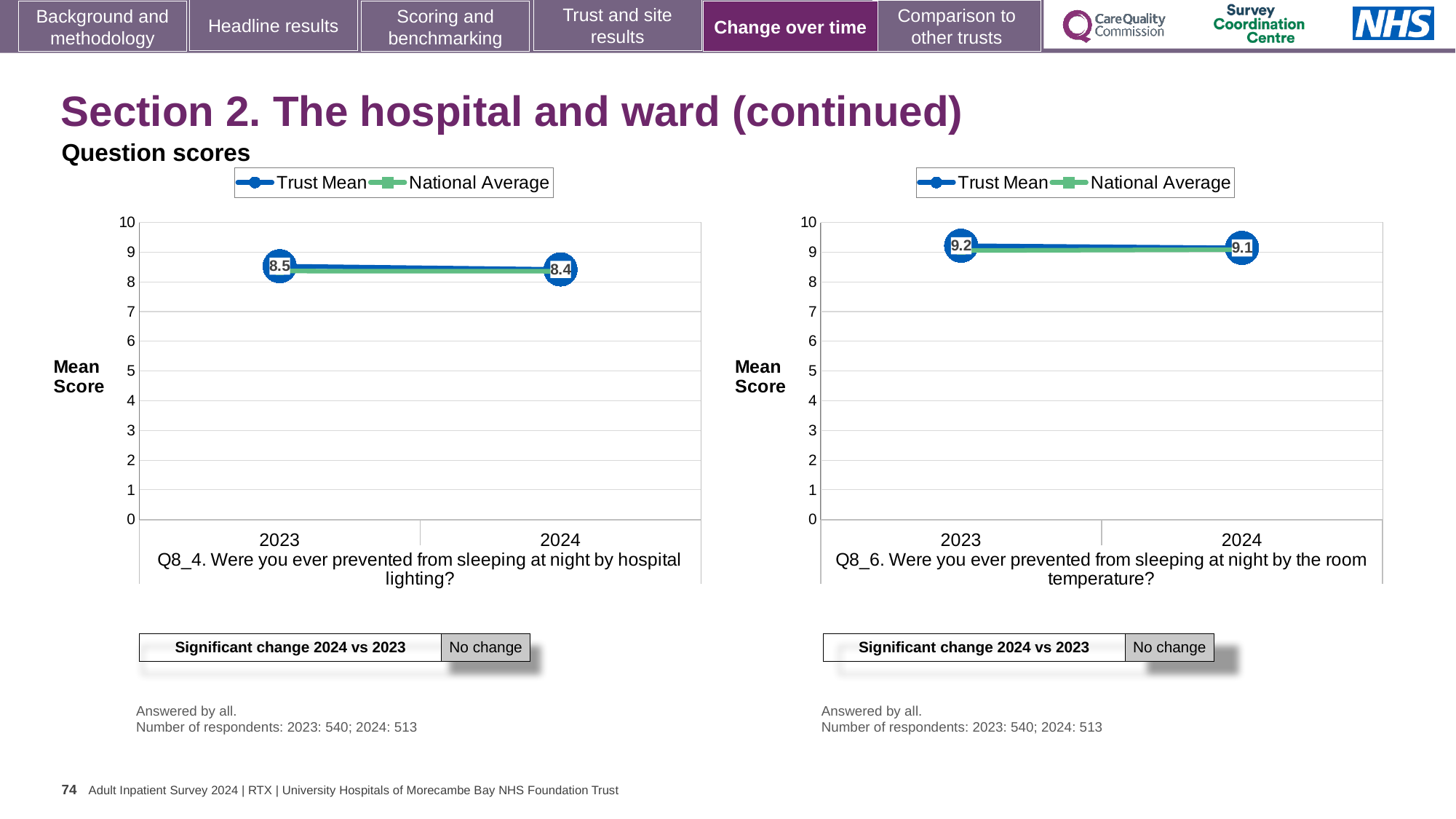
In the right chart (Q8_6, room temperature), what is the Trust Mean for 2024? 9.1 In the right chart (Q8_6, room temperature), is the National Average for 2024 greater or less than 5? greater In the left chart (Q8_4, hospital lighting), what is the Trust Mean for 2023? 8.5 In the right chart (Q8_6, room temperature), what is the Trust Mean for 2023? 9.2 In the right chart (Q8_6, room temperature), how many years are plotted on the x axis? 2 In the left chart (Q8_4, hospital lighting), what is the difference between the Trust Mean for 2023 and 2024? 0.1 In the left chart (Q8_4, hospital lighting), what are the two series named in the legend? Trust Mean and National Average In the left chart (Q8_4, hospital lighting), how many series does the legend list? 2 In the right chart (Q8_6, room temperature), does the Trust Mean rise or fall from 2023 to 2024? fall Which chart has the higher Trust Mean for 2023, the left chart (Q8_4) or the right chart (Q8_6)? the right chart (Q8_6) In the left chart (Q8_4, hospital lighting), what is the Trust Mean for 2024? 8.4 What kind of chart is the left chart (Q8_4, hospital lighting)? line chart